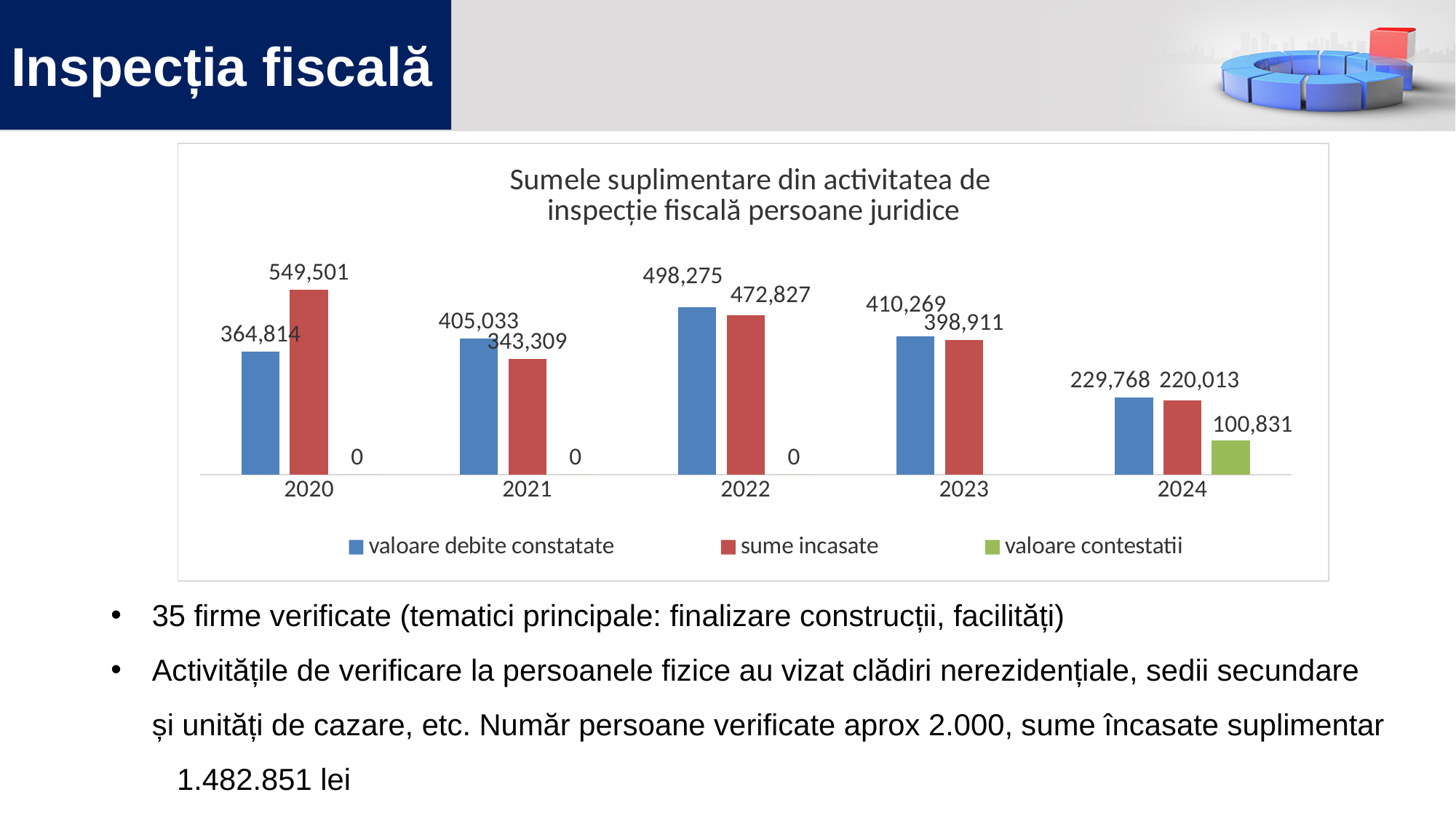
What is the value of 'sume incasate' for 2020? 549,501 What is the difference between 'valoare debite constatate' and 'sume incasate' in 2022? 25,448 What is the value of 'valoare debite constatate' for 2022? 498,275 How many series does the chart legend list? 3 Does 'sume incasate' rise or fall from 2022 to 2024? fall In which year is 'valoare debite constatate' the highest? 2022 In which year is 'sume incasate' the lowest? 2024 In 2021, which is larger: 'valoare debite constatate' or 'sume incasate'? valoare debite constatate What kind of chart is shown on the slide? bar chart What is the value of 'valoare contestatii' for 2024? 100,831 How many years are shown on the x axis of the chart? 5 What is the difference between 'sume incasate' and 'valoare debite constatate' in 2020? 184,687